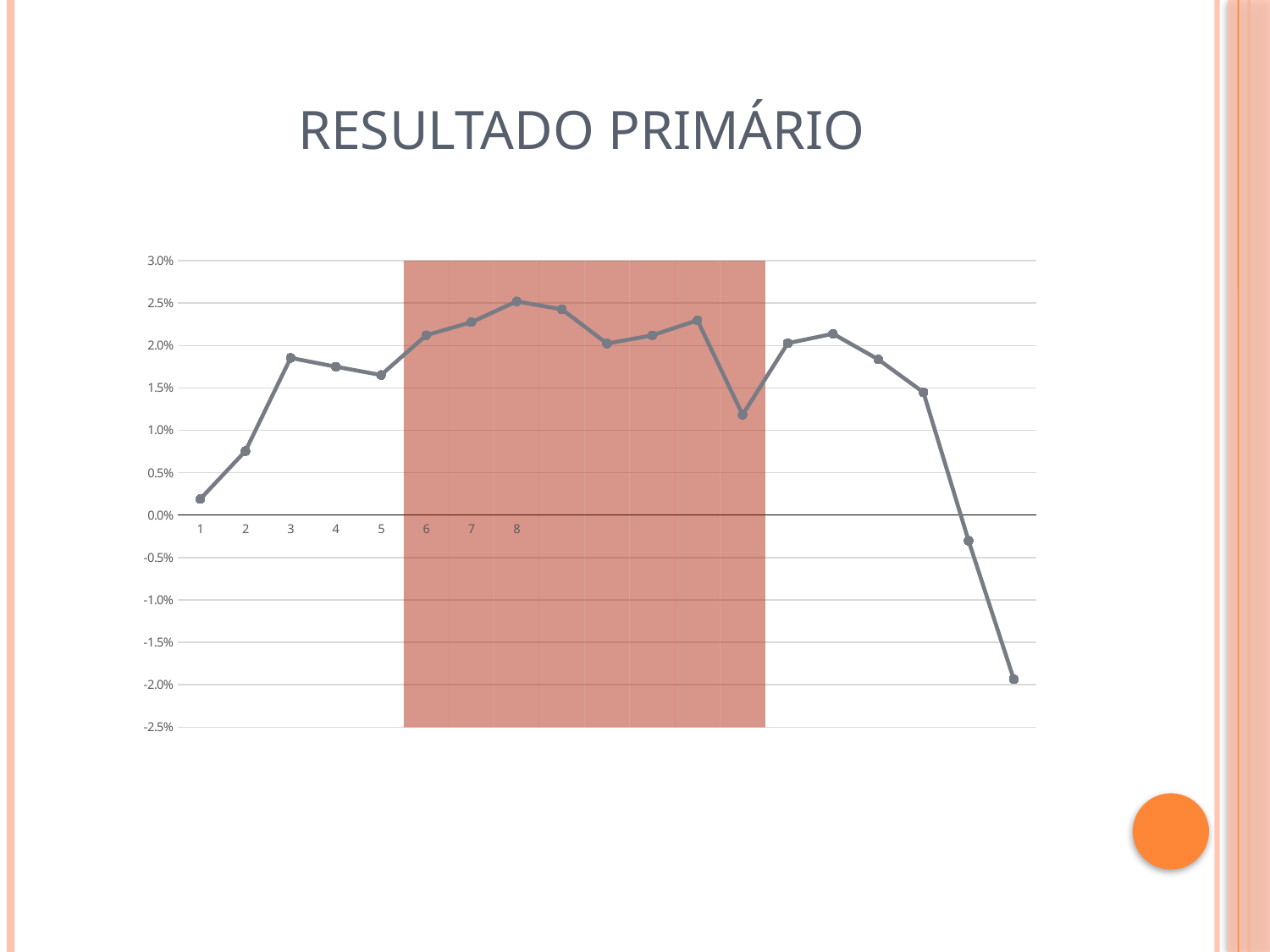
What is the title of the chart? RESULTADO PRIMÁRIO Which has the larger value, category 1 or category 3? category 3 What kind of chart is shown on the slide? line chart Is the value for category 2 greater or less than 0.5%? greater Is the value for category 1 greater or less than 0.5%? less Is the value for category 3 greater or less than 1.5%? greater Among the labelled categories 1 to 8, which has the highest value? 8 Which has the larger value, category 2 or category 8? category 8 Do the values rise or fall from category 1 to category 3? rise Among the labelled categories 1 to 8, which has the lowest value? 1